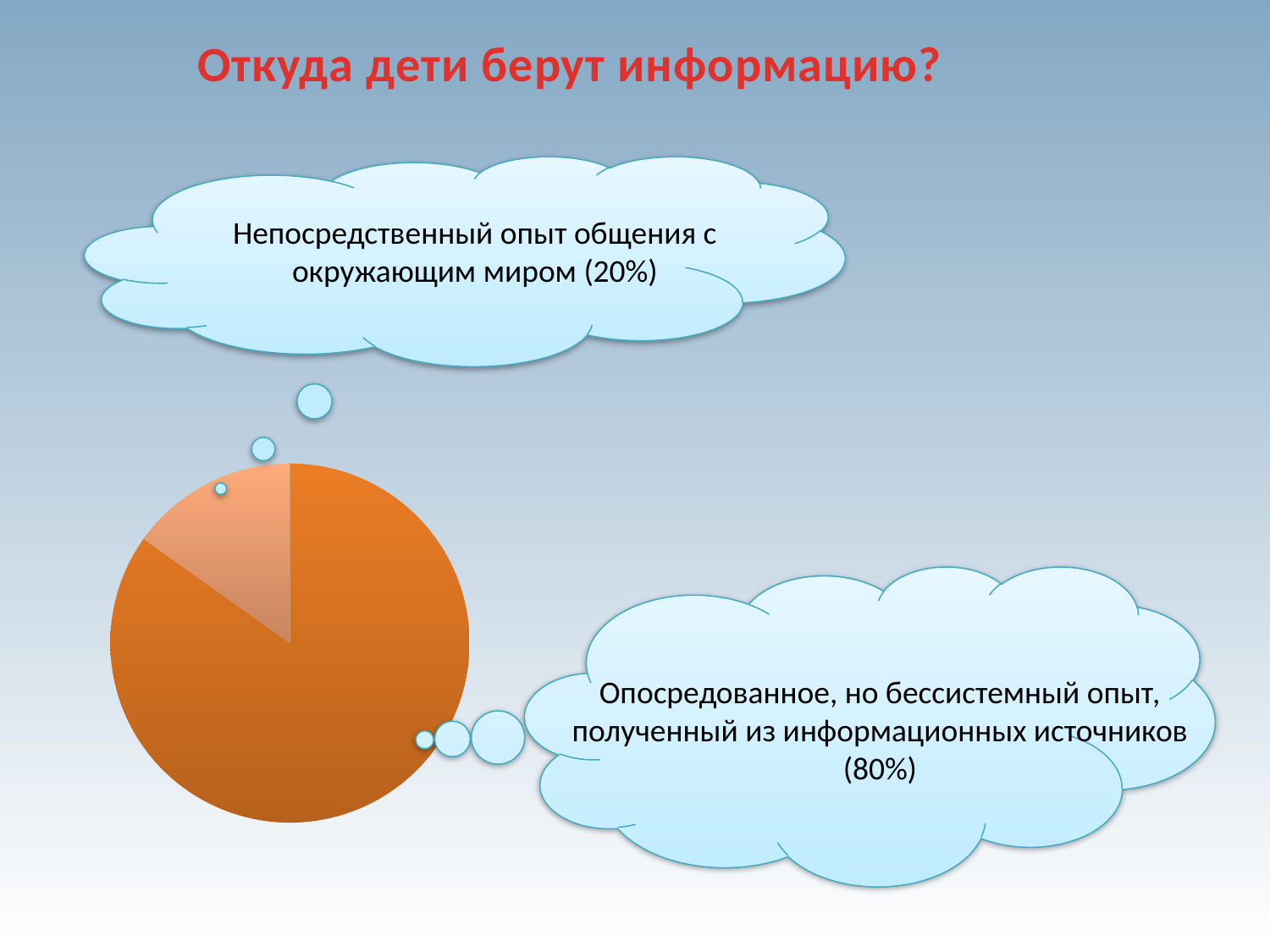
What share of the pie is labelled "Непосредственный опыт общения с окружающим миром"? 20% What is the title of the slide containing the pie chart? Откуда дети берут информацию? Which source of information has the largest slice of the pie? Опосредованное, но бессистемный опыт, полученный из информационных источников What kind of chart is shown on the slide? pie chart Which is larger: the share for direct experience with the surrounding world (Непосредственный опыт) or the share for experience from information sources (Опосредованное)? Опосредованное, но бессистемный опыт, полученный из информационных источников How many slices does the pie chart have? 2 What colour is the larger slice of the pie chart? orange Which source of information has the smallest slice of the pie? Непосредственный опыт общения с окружающим миром What share of the pie is labelled "Опосредованное, но бессистемный опыт, полученный из информационных источников"? 80% By how many percentage points does the share for information sources (80%) exceed the share for direct experience (20%)? 60